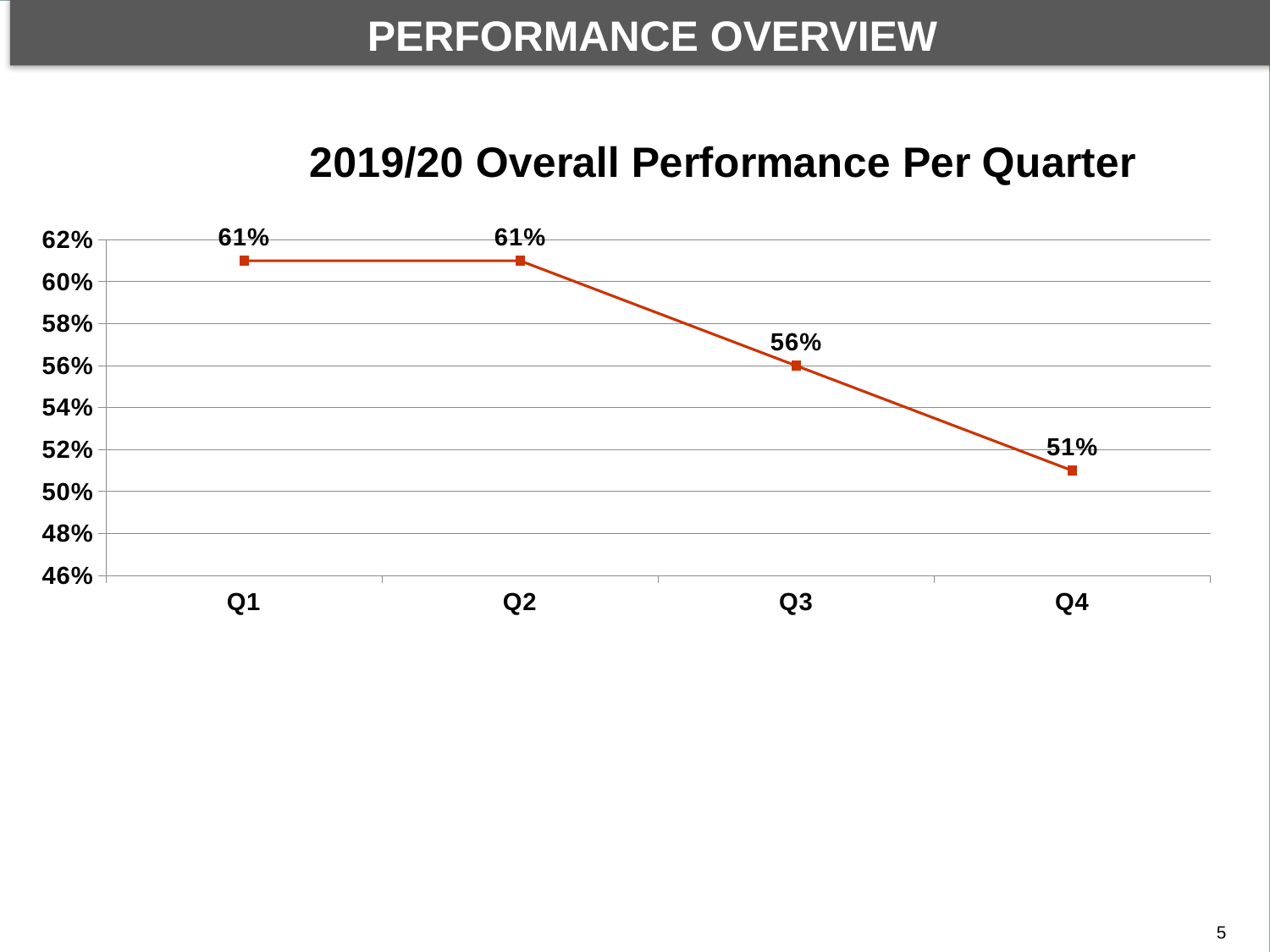
What is the title of the chart? 2019/20 Overall Performance Per Quarter Is the value for Q3 greater or less than 54%? greater Which quarter has the lowest value? Q4 What kind of chart is shown? line chart Which is larger, the value for Q2 or the value for Q3? Q2 What is the value for Q3? 56% How many quarters are plotted on the chart? 4 What is the difference between the values for Q2 and Q4? 10% Do the values rise or fall from Q2 to Q4? fall What is the value for Q1? 61% What is the value for Q4? 51% What is the difference between the values for Q3 and Q4? 5%